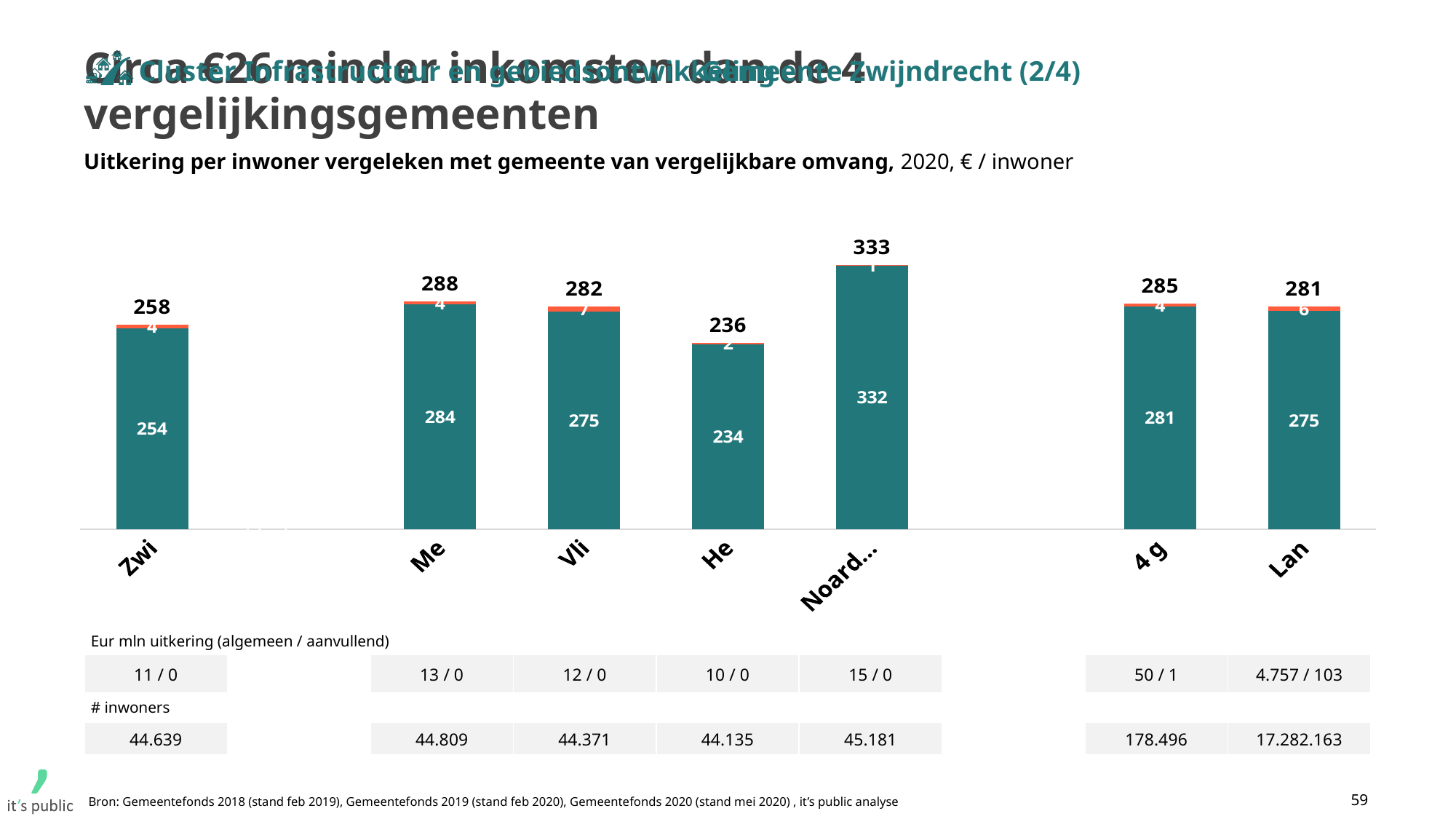
What kind of chart is shown on the slide? Stacked bar chart What is the value of the orange (upper) segment of the bar for Lan? 6 What is the value of the teal (lower) segment of the bar for Vli? 275 What is the difference between the total for Me and the total for Zwi? 30 What unit is stated in the chart subtitle for the values? € / inwoner Which is larger, the total for 4 g or the total for Lan? 4 g How many bars are shown in the chart? 7 Which category has the lowest total value? He What is the total value shown above the bar for Zwi? 258 What is the total of the stacked bar for He? 236 What is the value of the teal (lower) segment of the bar for Noard...? 332 Which category has the highest total value? Noard...